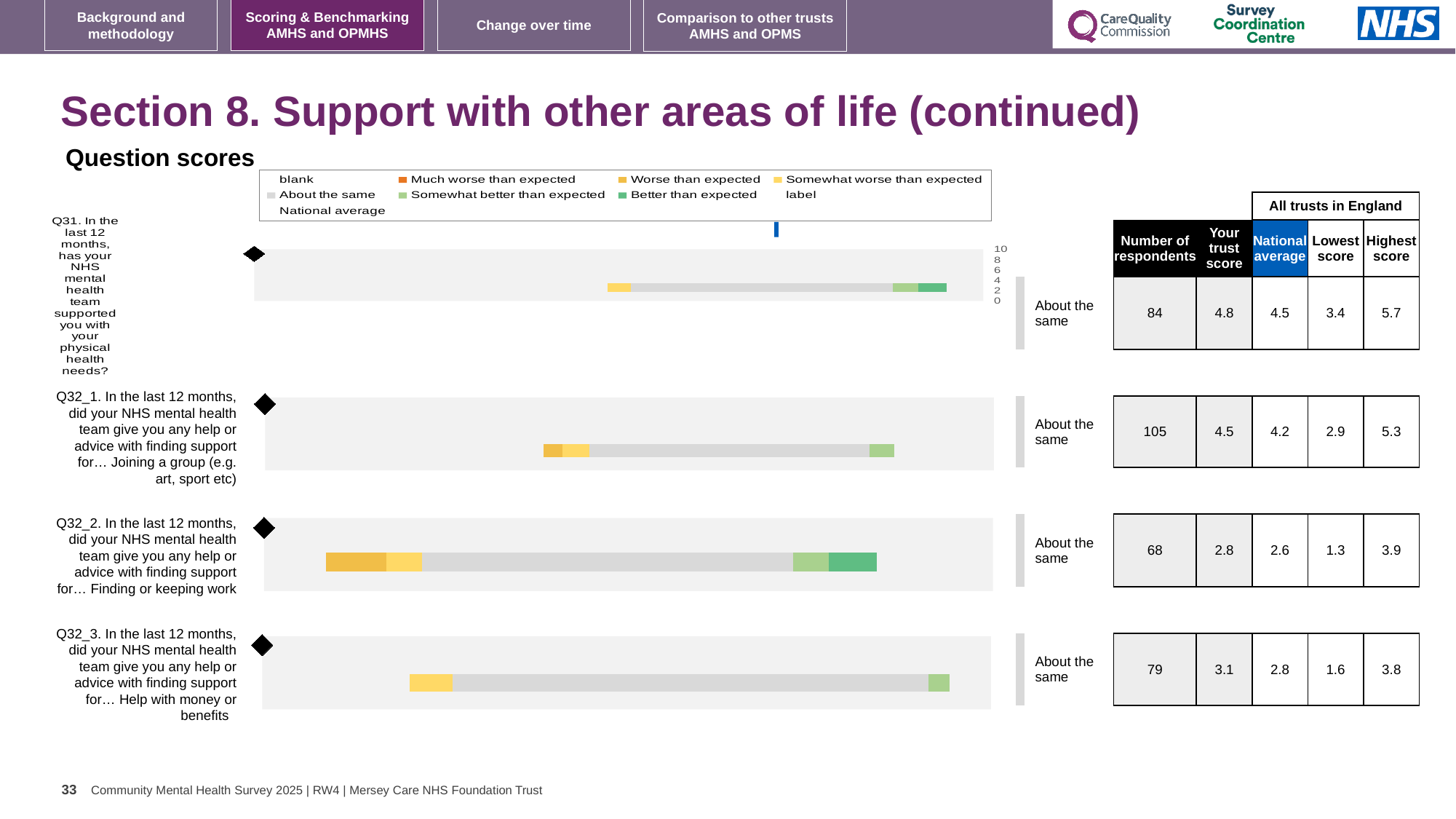
For the Q32_1 chart (joining a group), what is the national average score? 4.2 For the Q31 chart, how much higher is the highest score than 'Your trust score'? 0.9 For the Q31 chart (support with physical health needs), what is the 'Your trust score' value? 4.8 For the Q32_3 chart (help with money or benefits), which is larger: 'Your trust score' or the national average? Your trust score Which legend entry is shown in dark orange? Much worse than expected For the Q32_1 chart, what is the difference between the highest score and the lowest score across all trusts in England? 2.4 How many question charts are shown on the slide? 4 For the Q32_2 chart (finding or keeping work), what is the number of respondents? 68 What benchmark category label is shown next to each of the four question charts? About the same What kind of chart is used to show the question scores on this slide? bar chart Which question chart has the highest 'Your trust score'? Q31 Which question chart has the lowest national average score? Q32_2